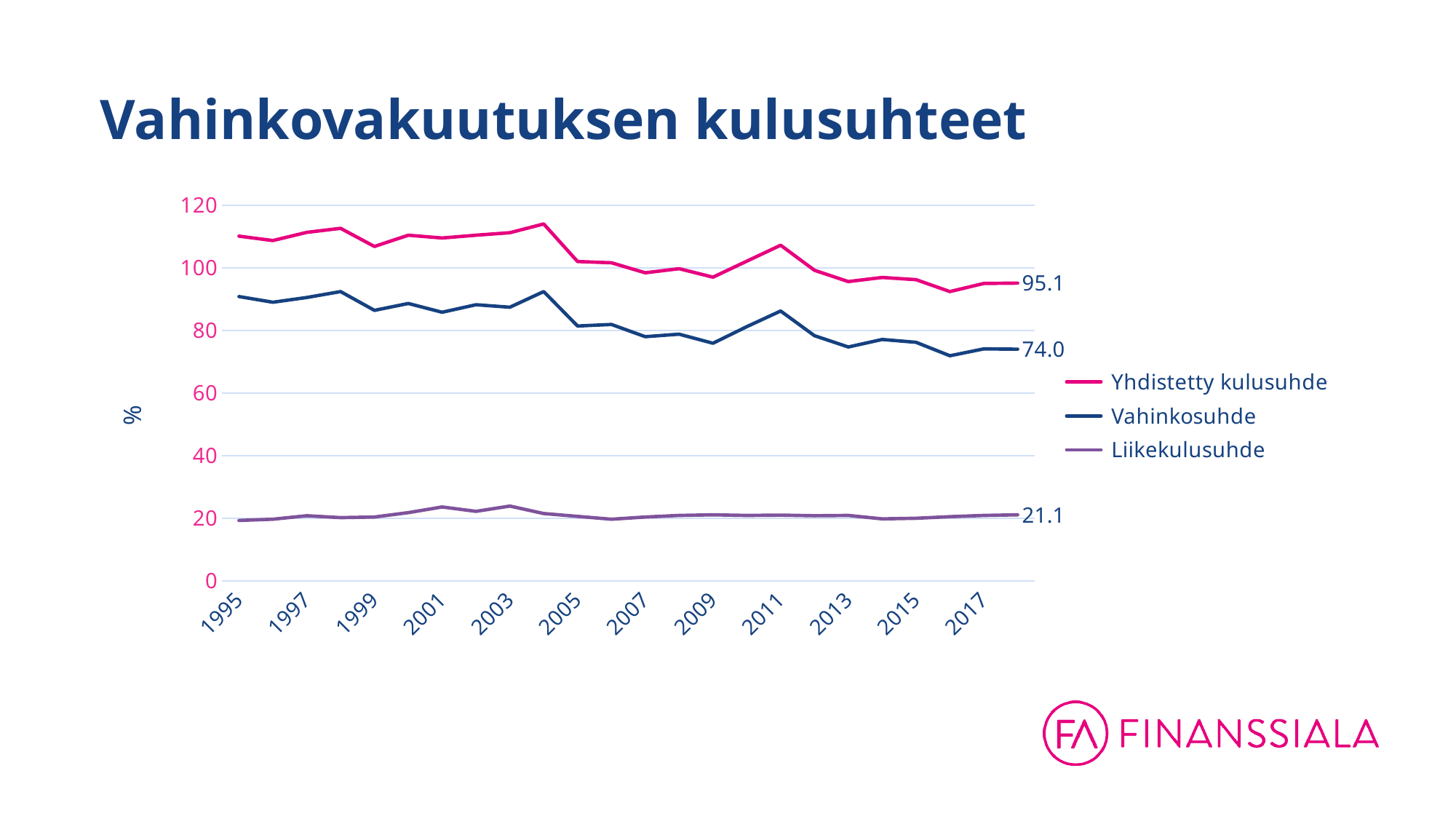
Is the value for Yhdistetty kulusuhde in 1995 greater or less than 100? greater What is the final labelled value of the Vahinkosuhde line? 74.0 What is the final labelled value of the Yhdistetty kulusuhde line? 95.1 Which series has the lowest values throughout the chart? Liikekulusuhde Is the value for Vahinkosuhde in 2017 greater or less than 80? less What kind of chart is shown on the slide? line chart Does the Yhdistetty kulusuhde line generally rise or fall from 1995 to the end of the period? fall Which series has the highest values throughout the chart? Yhdistetty kulusuhde What is the difference between the final labelled values of Yhdistetty kulusuhde and Vahinkosuhde? 21.1 How many series does the legend list? 3 What is the title of the chart on the slide? Vahinkovakuutuksen kulusuhteet What is the final labelled value of the Liikekulusuhde line? 21.1